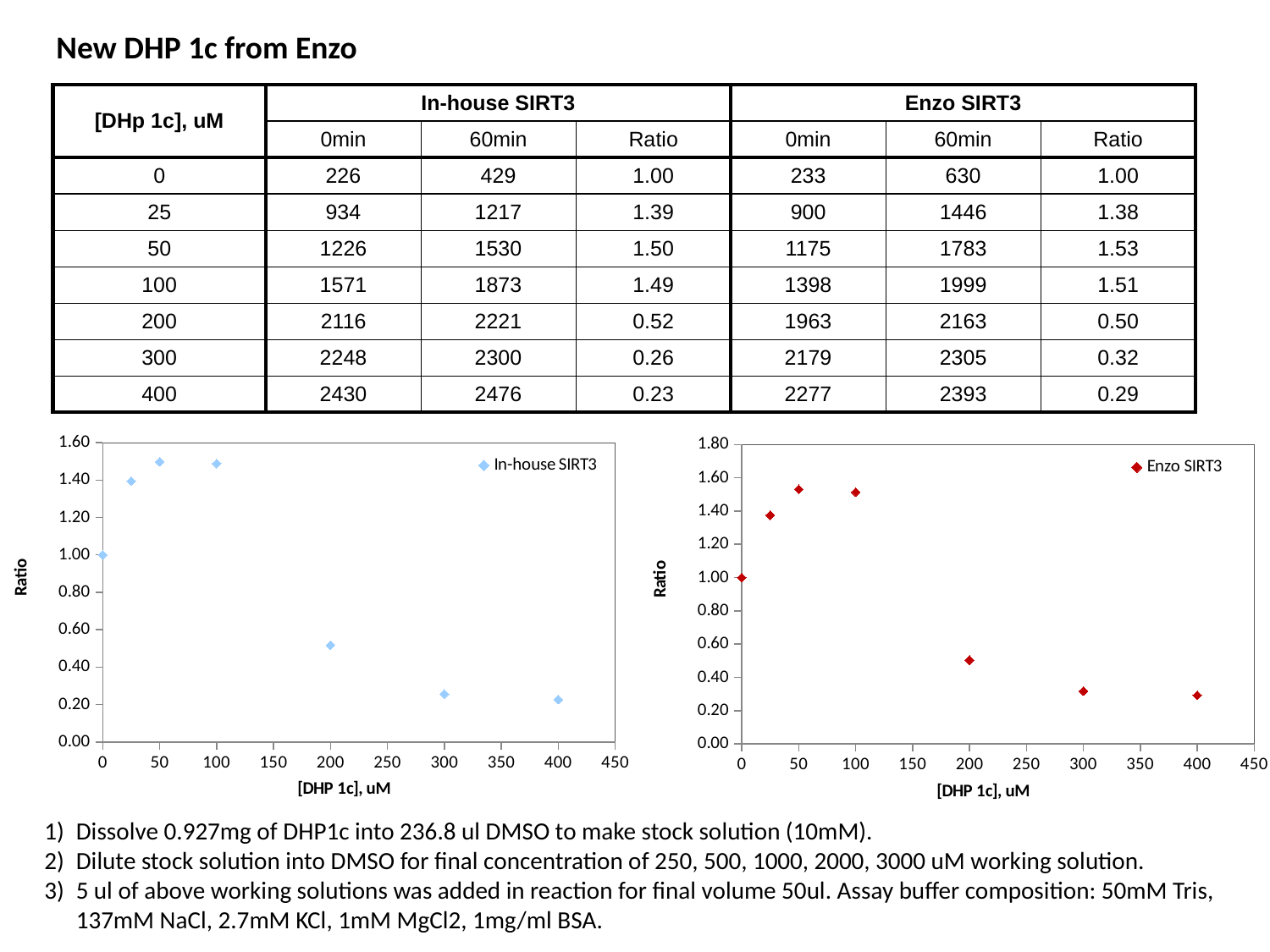
In the Enzo SIRT3 chart, is the Ratio at 100 uM greater or less than 1.40? greater In the Enzo SIRT3 chart, what is the Ratio at 400 uM [DHP 1c]? 0.29 What kind of chart is the In-house SIRT3 chart on the left? scatter chart What is the x-axis label of the Enzo SIRT3 chart? [DHP 1c], uM How many series does the legend of the In-house SIRT3 chart list? 1 In the Enzo SIRT3 chart on the right, how many data points are plotted? 7 In the In-house SIRT3 chart, is the Ratio at 200 uM greater or less than 0.60? less In the Enzo SIRT3 chart, at which [DHP 1c] concentration is the Ratio lowest? 400 In the In-house SIRT3 chart, at which [DHP 1c] concentration is the Ratio highest? 50 In the Enzo SIRT3 chart, which has the larger Ratio: 25 uM or 300 uM? 25 uM In the In-house SIRT3 chart, does the Ratio rise or fall between 100 uM and 400 uM? fall In the In-house SIRT3 chart, what is the Ratio at 0 uM [DHP 1c]? 1.00